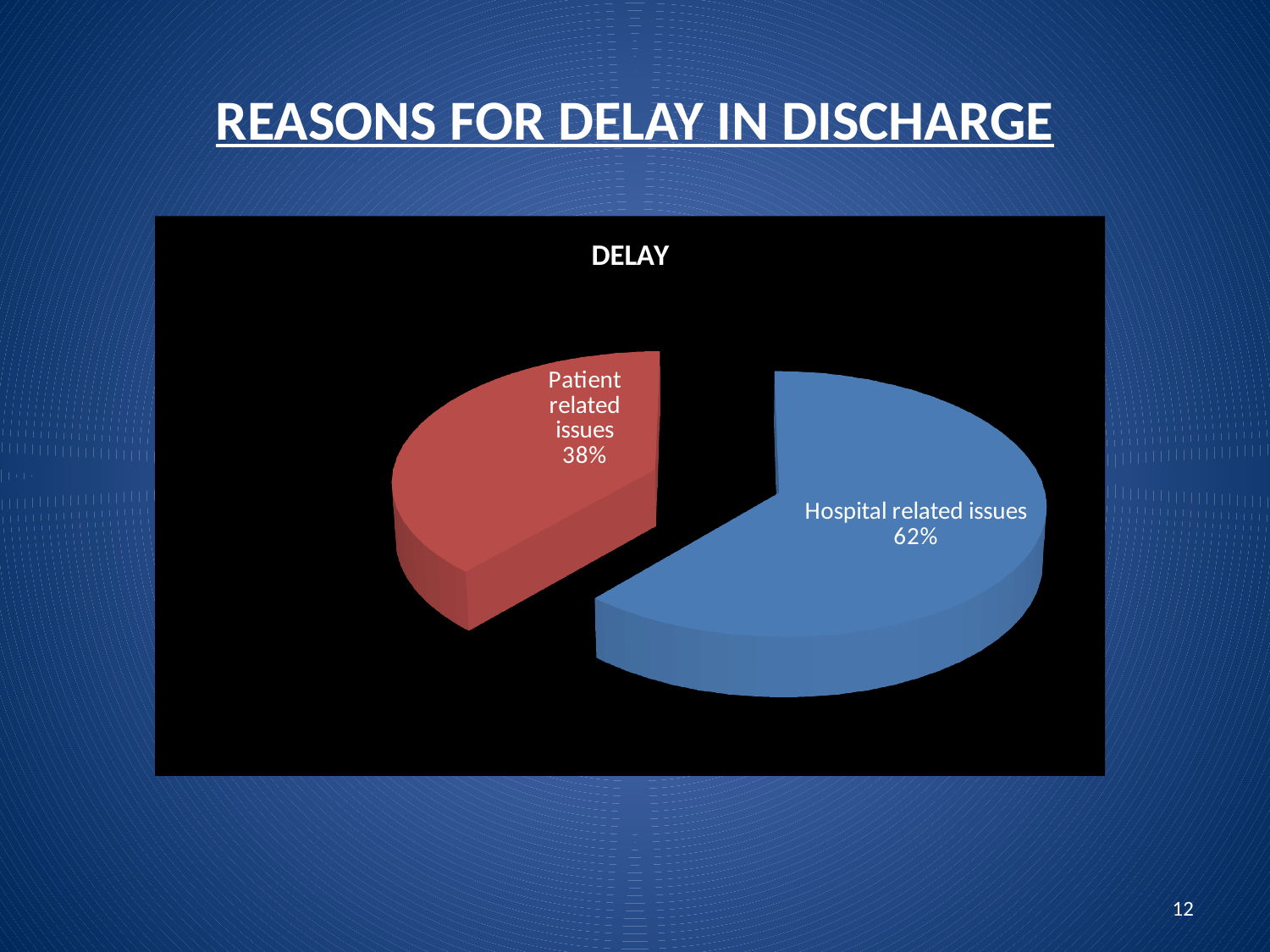
How many slices does the pie chart have? 2 Which category has the smallest slice of the pie? Patient related issues What is the title of the chart? DELAY What is the difference in percentage points between Hospital related issues and Patient related issues? 24 What kind of chart is shown on the slide? Pie chart Which category has the largest slice of the pie? Hospital related issues What share of the pie does Hospital related issues account for? 62% What share of the pie does Patient related issues account for? 38% What colour is the slice for Patient related issues? Red Which is larger, the slice for Hospital related issues or the slice for Patient related issues? Hospital related issues